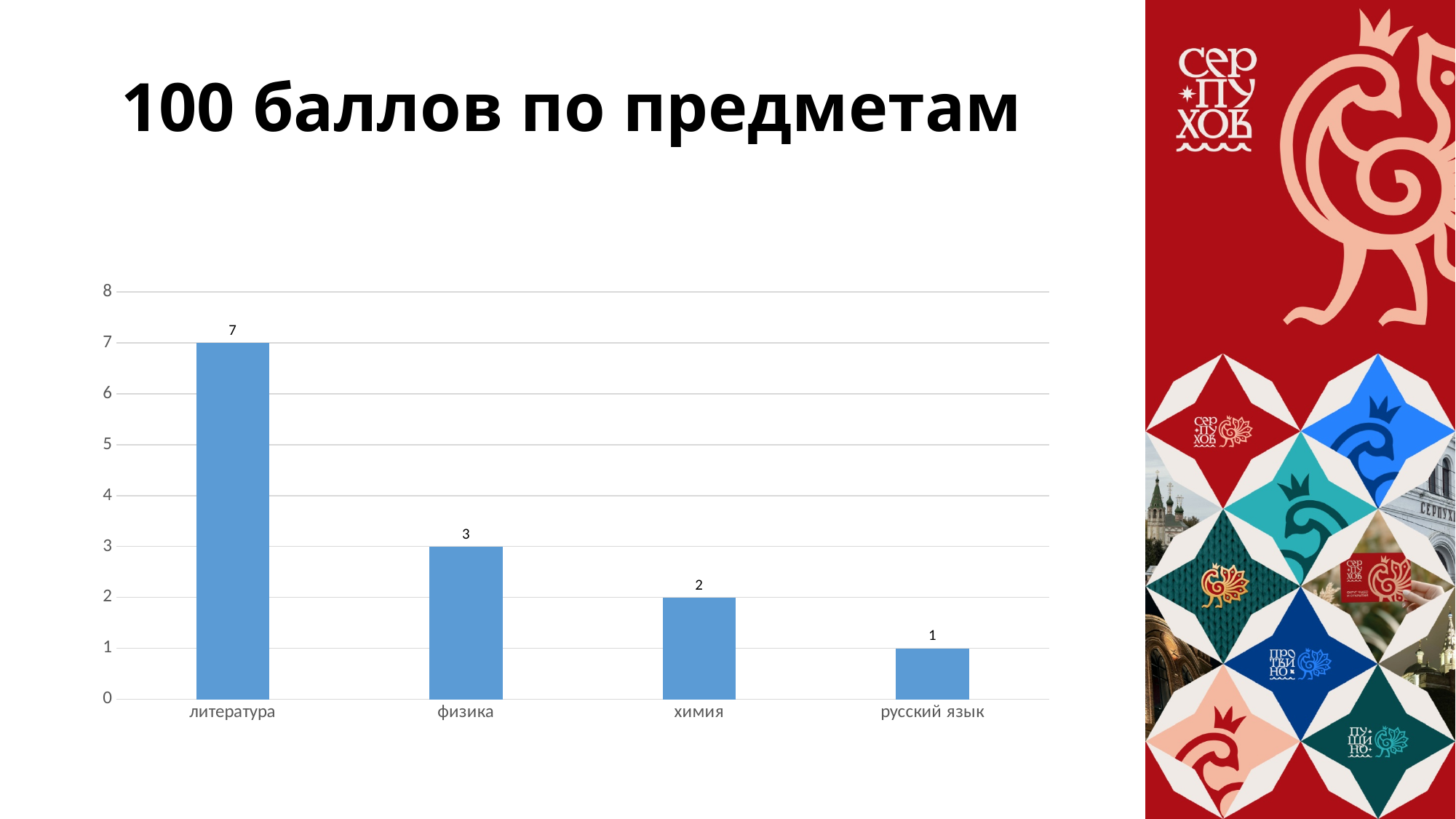
Is the value for литература greater or less than 5? greater What is the value for русский язык? 1 Which is larger, the value for химия or the value for русский язык? химия How many categories are shown on the chart? 4 What is the value for химия? 2 Which category has the lowest value? русский язык What is the value for физика? 3 What is the difference between the values for литература and физика? 4 What is the value for литература? 7 What kind of chart is shown on the slide? bar chart What is the title of the slide? 100 баллов по предметам Which category has the highest value? литература